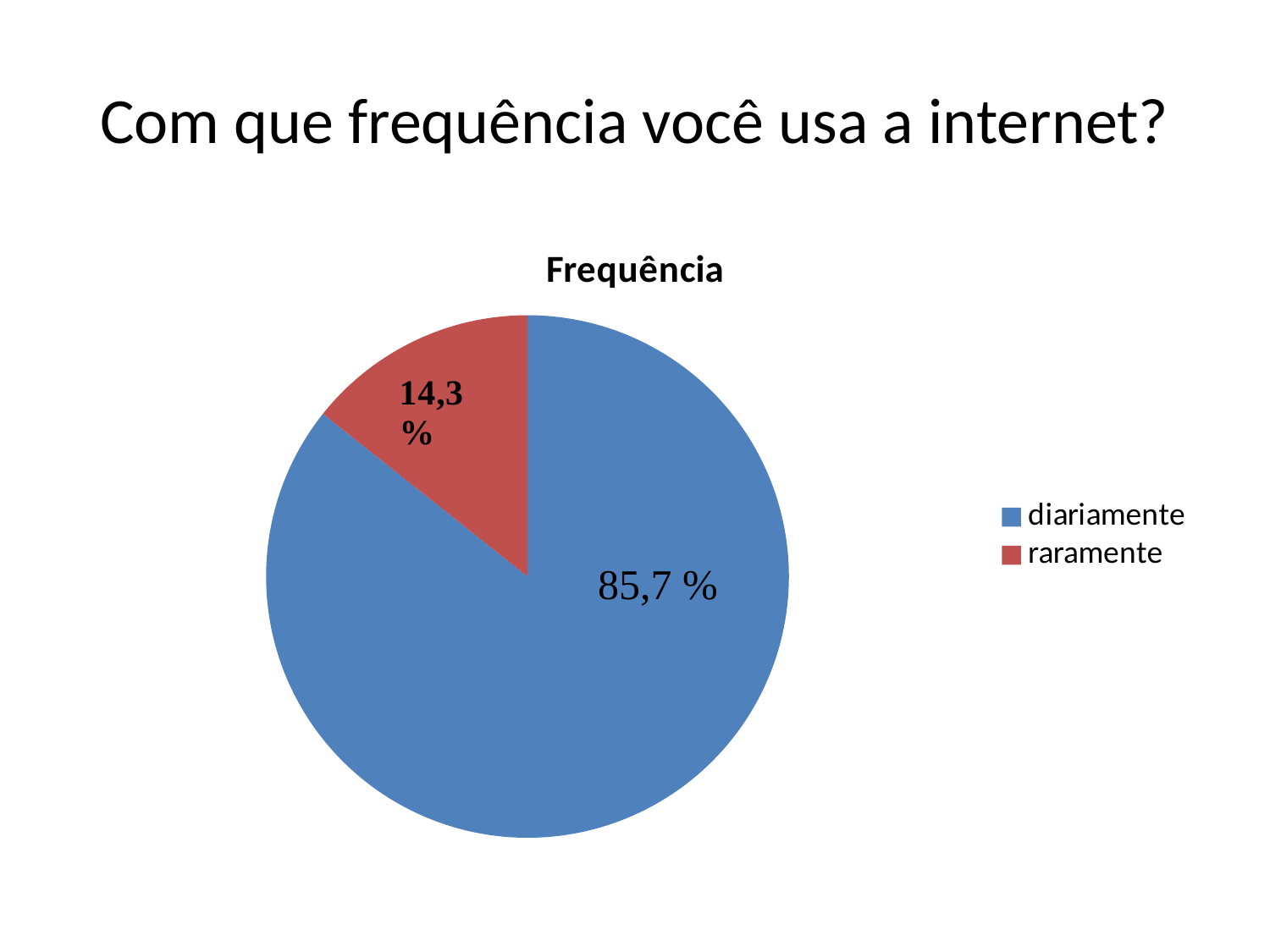
What share of the pie does 'raramente' represent? 14,3 % What kind of chart is shown on the slide? pie chart Which category has the largest slice? diariamente How many categories does the pie chart show? 2 What share of the pie does 'diariamente' represent? 85,7 % Which is larger, the slice for 'diariamente' or the slice for 'raramente'? diariamente What is the title of the chart? Frequência What colour is the 'raramente' slice? red How many entries does the legend list? 2 What is the difference in percentage points between the 'diariamente' and 'raramente' slices? 71,4 Which category has the smallest slice? raramente